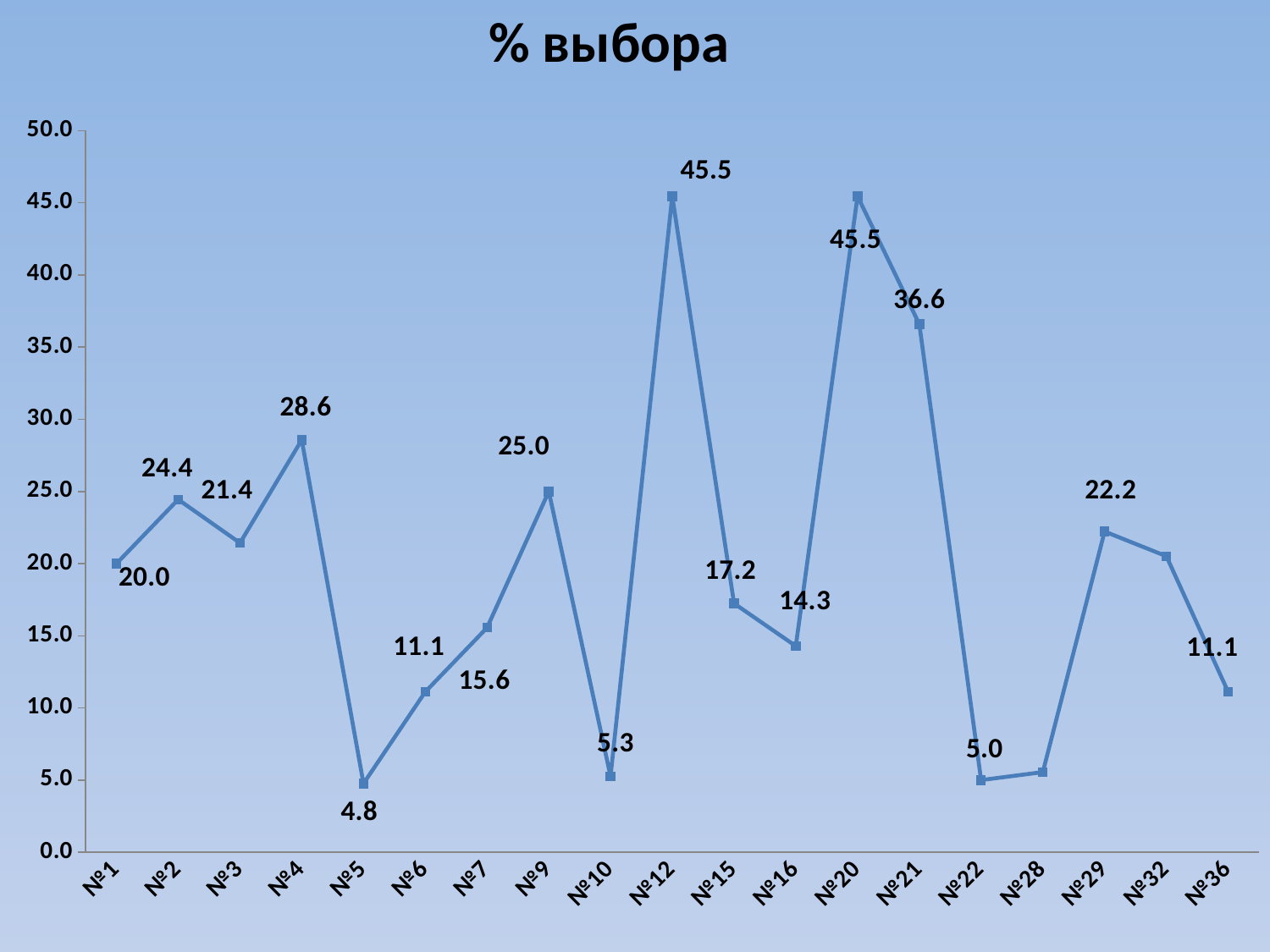
Which has the larger value, №21 or №9? №21 What is the lowest value plotted on the chart? 4.8 What is the value for №21? 36.6 Do the values rise or fall from №5 to №9? rise What is the highest value plotted on the chart? 45.5 How many categories are plotted on the x axis? 19 What is the value for №29? 22.2 What is the value for №12? 45.5 Is the value for №28 greater or less than 10.0? less What is the difference between the values for №12 and №15? 28.3 What kind of chart is shown on the slide? line chart What is the value for №5? 4.8